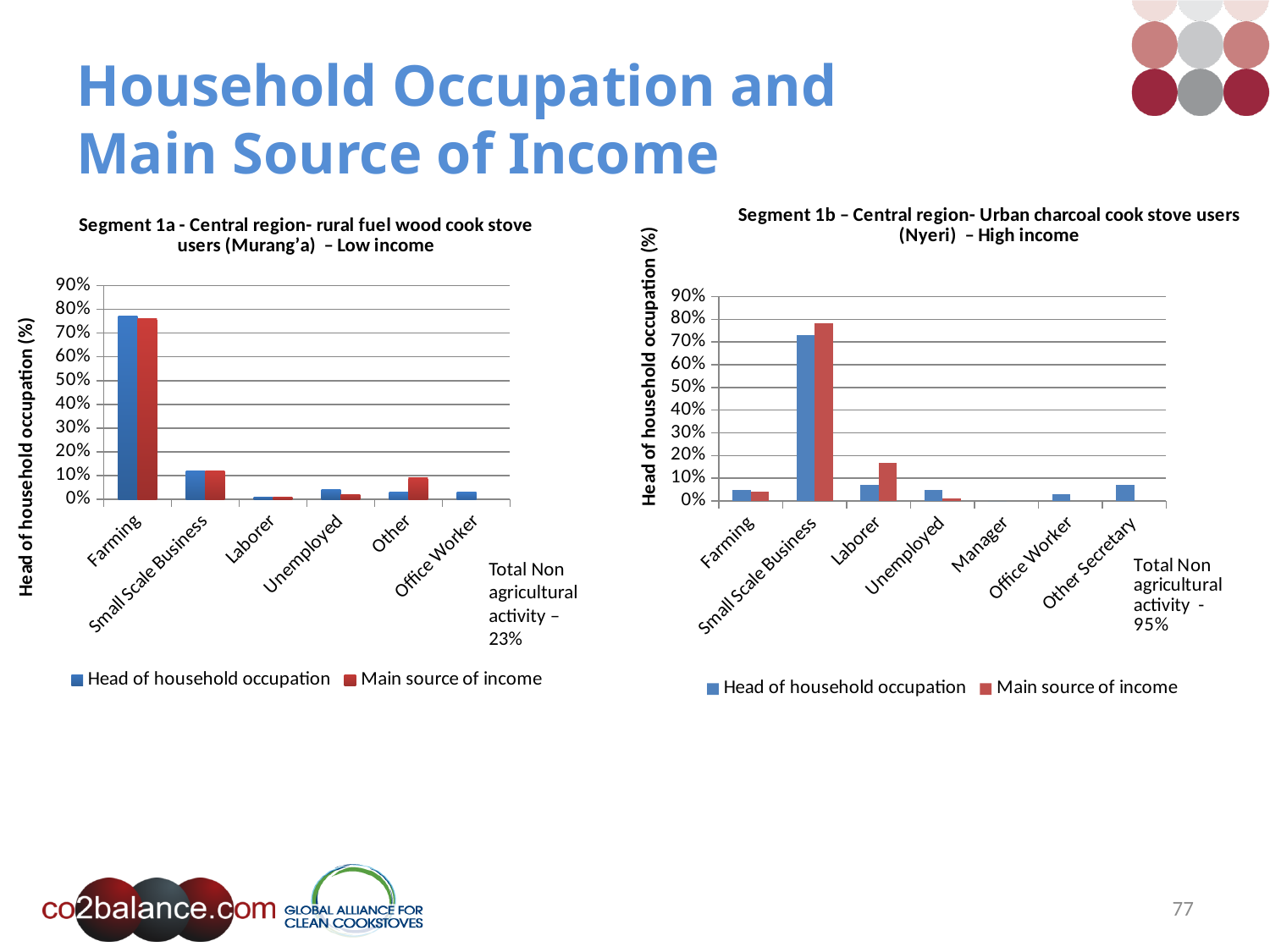
In the Segment 1b chart (right), for Laborer, which series has the larger value: Head of household occupation or Main source of income? Main source of income In the Segment 1a chart (left), is the Head of household occupation value for Farming greater or less than 70%? greater In the Segment 1a chart (left), is the Head of household occupation value for Small Scale Business greater or less than 20%? less In the Segment 1b chart (right), is the Main source of income value for Small Scale Business greater or less than 70%? greater How many occupation categories are shown on the x axis of the Segment 1a chart (left)? 6 How many series does the legend of the Segment 1a chart (left) list? 2 In the Segment 1a chart (left), which category has the highest value for Head of household occupation? Farming In the Segment 1b chart (right), for Small Scale Business, which series has the larger value: Head of household occupation or Main source of income? Main source of income How many occupation categories are shown on the x axis of the Segment 1b chart (right)? 7 What type of chart is the Segment 1b chart (right)? Bar chart In the Segment 1b chart (right), which category has the highest value for Main source of income? Small Scale Business